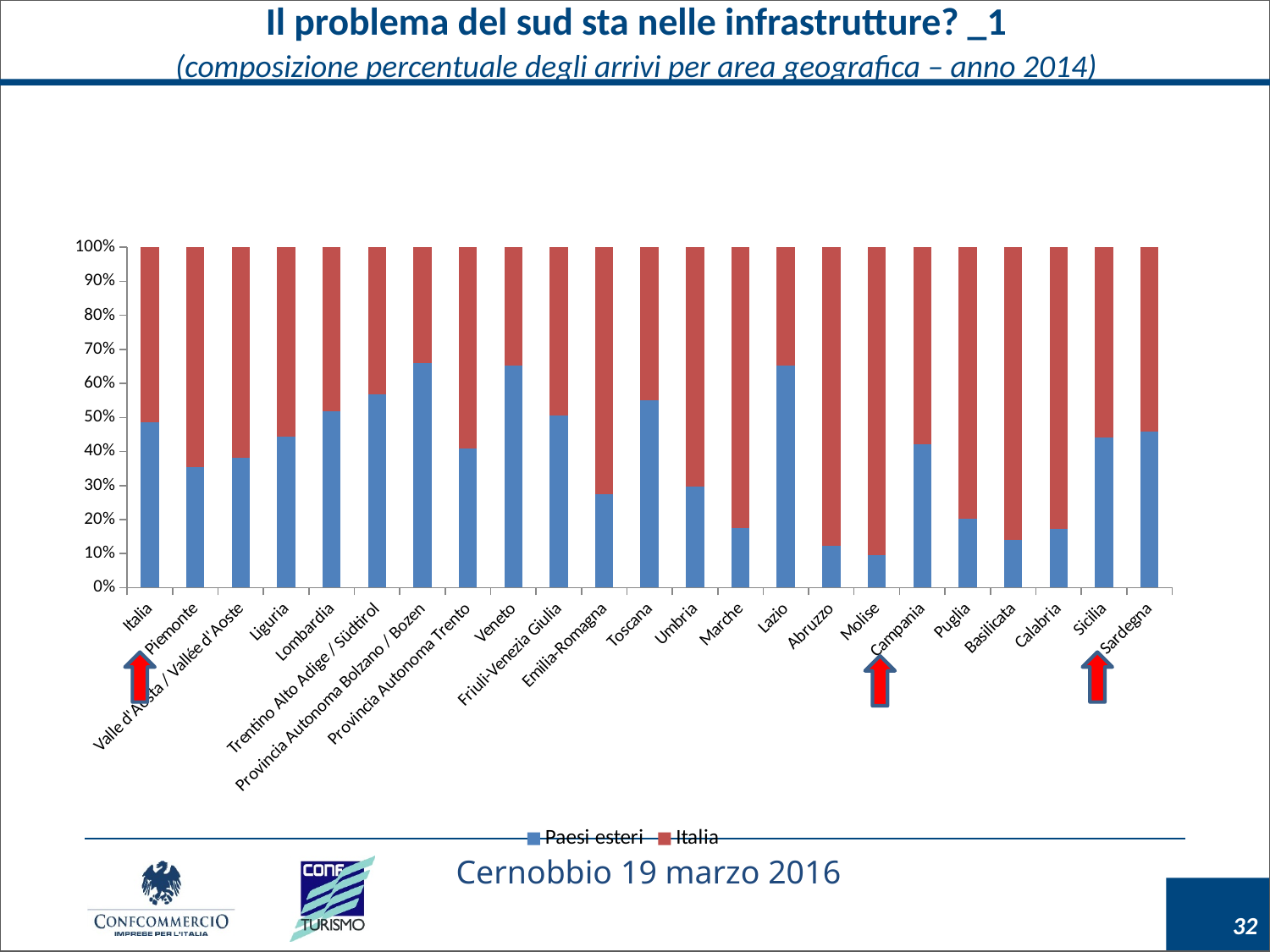
What are the two series named in the legend? Paesi esteri and Italia Is the Paesi esteri value for Marche greater or less than 20%? less What is the total of the stacked bar for Lazio? 100% How many geographic areas (categories) are plotted on the x axis? 23 Is the Paesi esteri value for Piemonte greater or less than 40%? less Which year does the chart subtitle say the data refer to? 2014 Is the Paesi esteri value for Trentino Alto Adige / Südtirol greater or less than 50%? greater Which has the larger Paesi esteri share, Lazio or Marche? Lazio What kind of chart is shown on the slide? Stacked bar chart Which has the larger Paesi esteri share, Provincia Autonoma Bolzano / Bozen or Provincia Autonoma Trento? Provincia Autonoma Bolzano / Bozen How many series does the legend list? 2